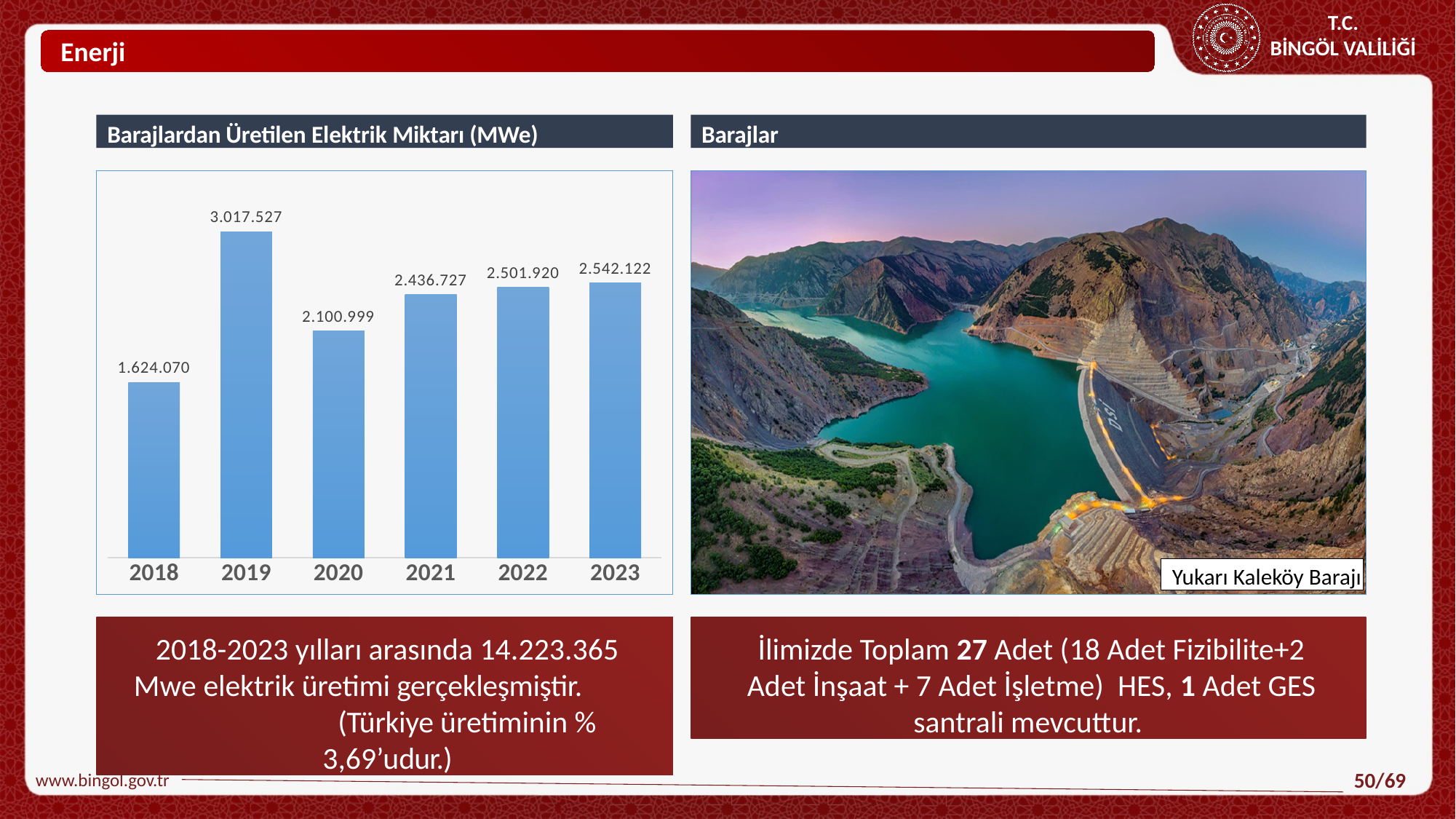
What is the difference between the values for 2021 and 2020? 335.728 What is the value for 2018 in the bar chart? 1.624.070 Do the values rise or fall from 2020 to 2023? rise How many years are shown in the bar chart? 6 What kind of chart is shown on the slide? bar chart Which year has the highest value in the bar chart? 2019 What is the value for 2019 in the bar chart? 3.017.527 Which is larger, the value for 2020 or the value for 2021? 2021 What is the value for 2020 in the bar chart? 2.100.999 What is the value for 2023 in the bar chart? 2.542.122 What is the difference between the values for 2023 and 2022? 40.202 Which year has the lowest value in the bar chart? 2018